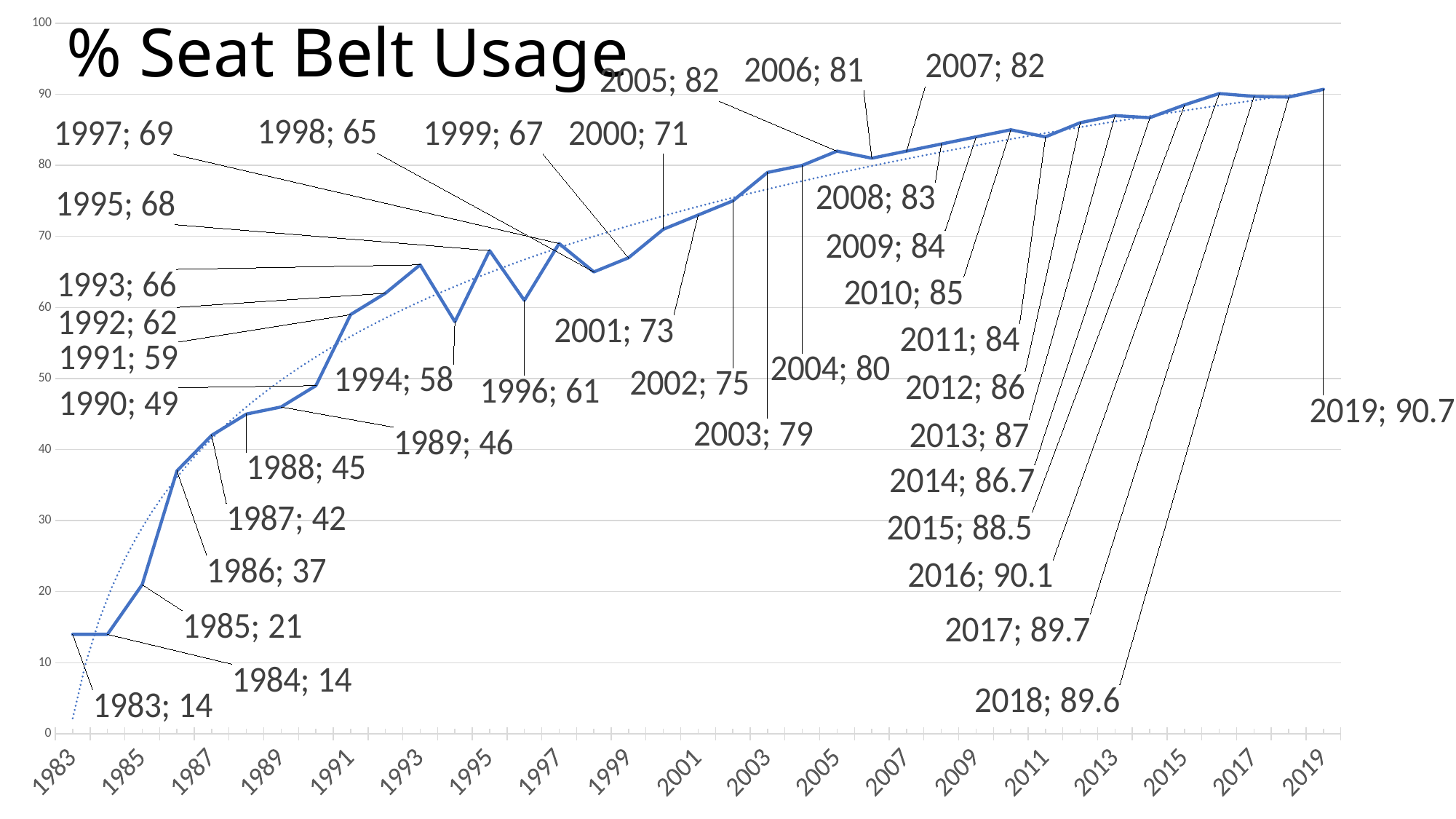
What is the title of the chart? % Seat Belt Usage Which year has the highest value? 2019 What kind of chart is this? line chart What is the value for 1986? 37 What is the lowest value plotted on the chart? 14 How many data points are plotted on the chart? 37 What is the value for 1994? 58 What is the value for 2003? 79 What is the value for 2014? 86.7 What is the difference between the values for 2019 and 1983? 76.7 Which is larger, the value for 1995 or the value for 1996? 1995 What is the difference between the values for 1991 and 1990? 10